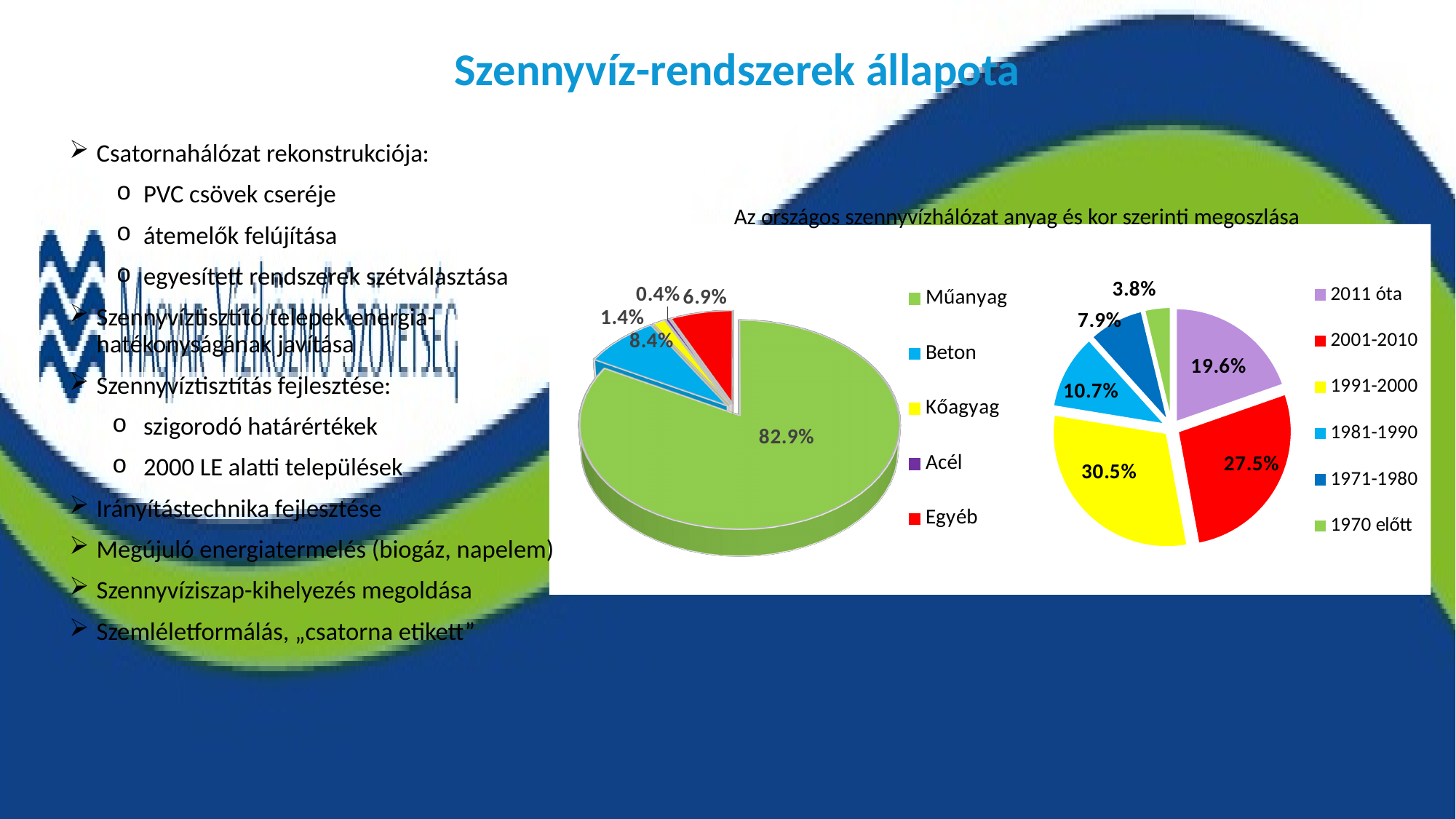
In the left pie chart (material), what share does Beton have? 8.4% In the right pie chart (age), what is the difference between the 2001-2010 and 1971-1980 shares? 19.6% In the left pie chart (material), what is the difference between the Egyéb and Kőagyag shares? 5.5% In the right pie chart (age), what share does 1991-2000 have? 30.5% What type of chart is used for the two charts on the right side of the slide? Pie chart In the right pie chart (age), what share does 1970 előtt have? 3.8% In the left pie chart (material), what share does Műanyag have? 82.9% In the left pie chart (material), which category has the smallest share? Acél In the right pie chart (age), which category has the largest share? 1991-2000 In the right pie chart (age), which is larger: 2011 óta or 1981-1990? 2011 óta In the left pie chart (material), how many slices are there? 5 In the right pie chart (age), how many categories does the legend list? 6